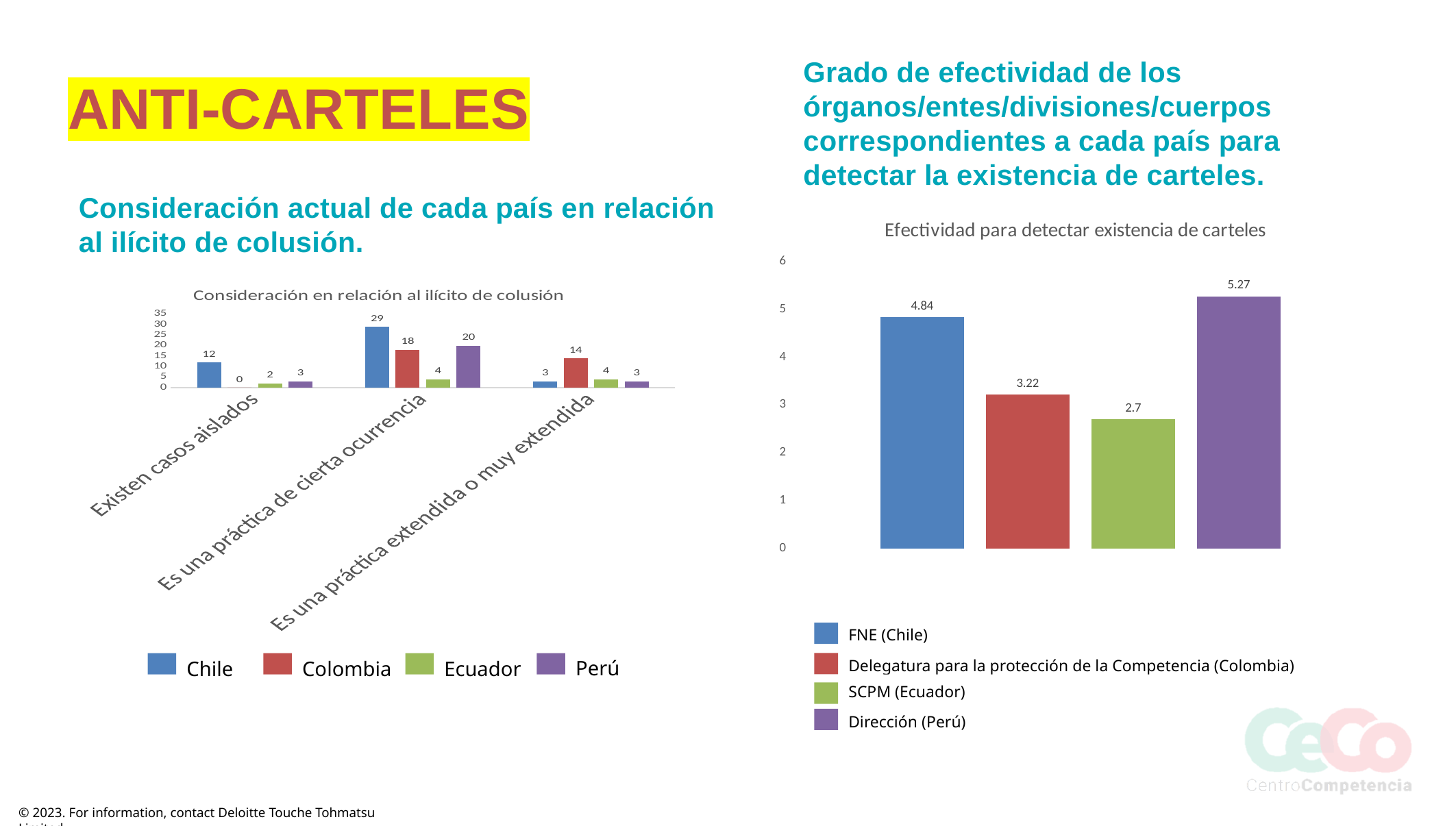
In the chart 'Efectividad para detectar existencia de carteles', which entity has the lowest value? SCPM (Ecuador) In the chart 'Consideración en relación al ilícito de colusión', how many categories are shown on the x axis? 3 In the chart 'Efectividad para detectar existencia de carteles', what is the value for FNE (Chile)? 4.84 In the chart 'Consideración en relación al ilícito de colusión', what is the difference between Chile and Perú in the category 'Es una práctica de cierta ocurrencia'? 9 In the chart 'Consideración en relación al ilícito de colusión', what is the value for Chile in the category 'Es una práctica de cierta ocurrencia'? 29 In the chart 'Efectividad para detectar existencia de carteles', what is the difference between the values for Dirección (Perú) and Delegatura para la protección de la Competencia (Colombia)? 2.05 In the chart 'Efectividad para detectar existencia de carteles', which entity has the highest value? Dirección (Perú) In the chart 'Consideración en relación al ilícito de colusión', which country has the highest value in the category 'Es una práctica extendida o muy extendida'? Colombia What type of chart is 'Consideración en relación al ilícito de colusión'? Bar chart In the chart 'Efectividad para detectar existencia de carteles', what is the value for SCPM (Ecuador)? 2.7 In the chart 'Efectividad para detectar existencia de carteles', how many entries does the legend list? 4 In the chart 'Consideración en relación al ilícito de colusión', what is the value for Colombia in the category 'Existen casos aislados'? 0